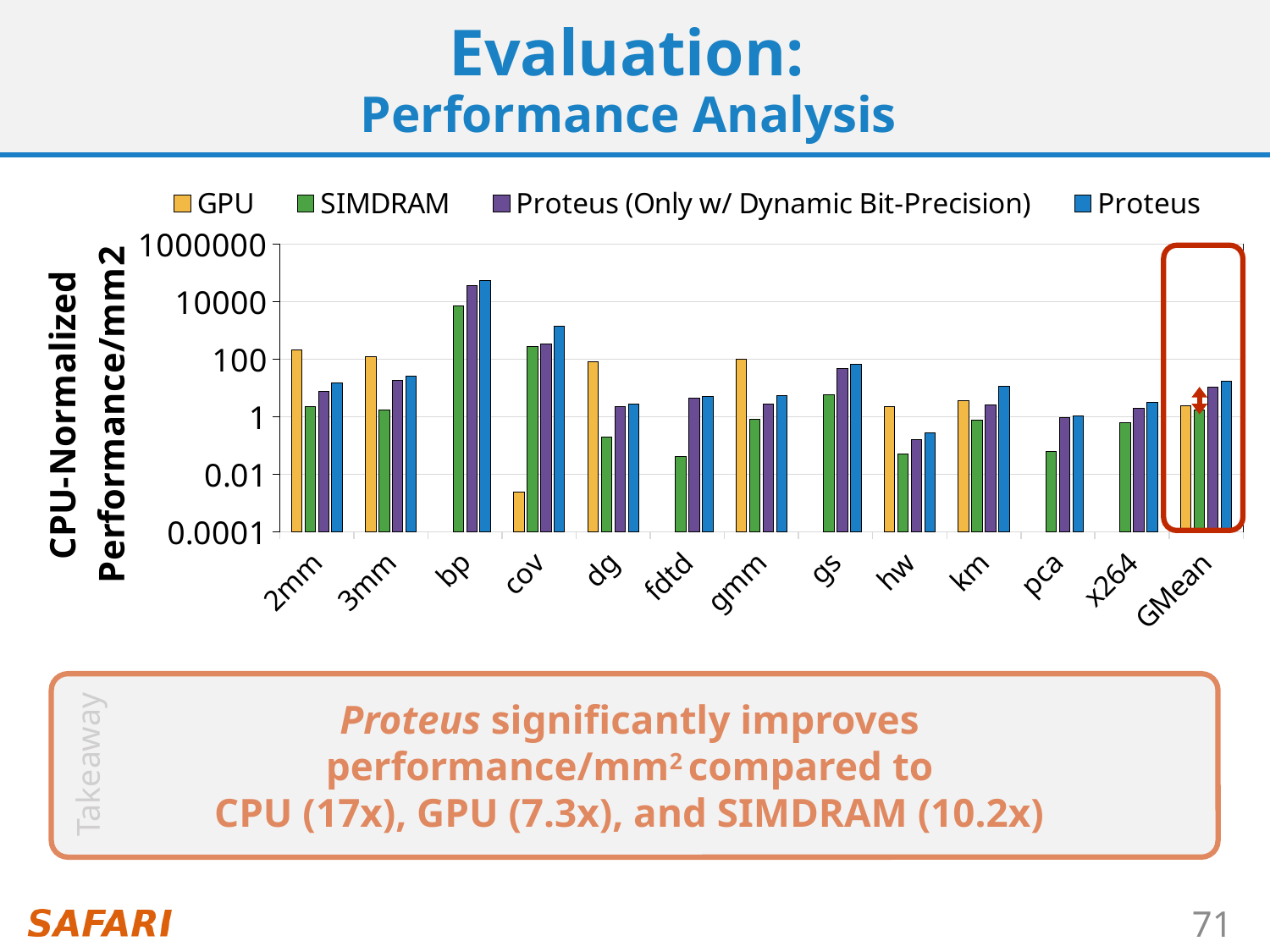
For 2mm, which is larger: the GPU value or the SIMDRAM value? GPU What kind of chart is shown on the slide? bar chart Which category has the lowest GPU value? cov How many categories are shown along the x axis? 13 Is the GPU value for cov greater or less than 0.01? less Is the Proteus value for bp greater or less than 10000? greater Is the GPU value for 2mm greater or less than 100? greater Which category has the highest Proteus value? bp How many series does the legend list? 4 For bp, which is larger: the SIMDRAM value or the Proteus value? Proteus Which category on the x axis is highlighted with a red box? GMean